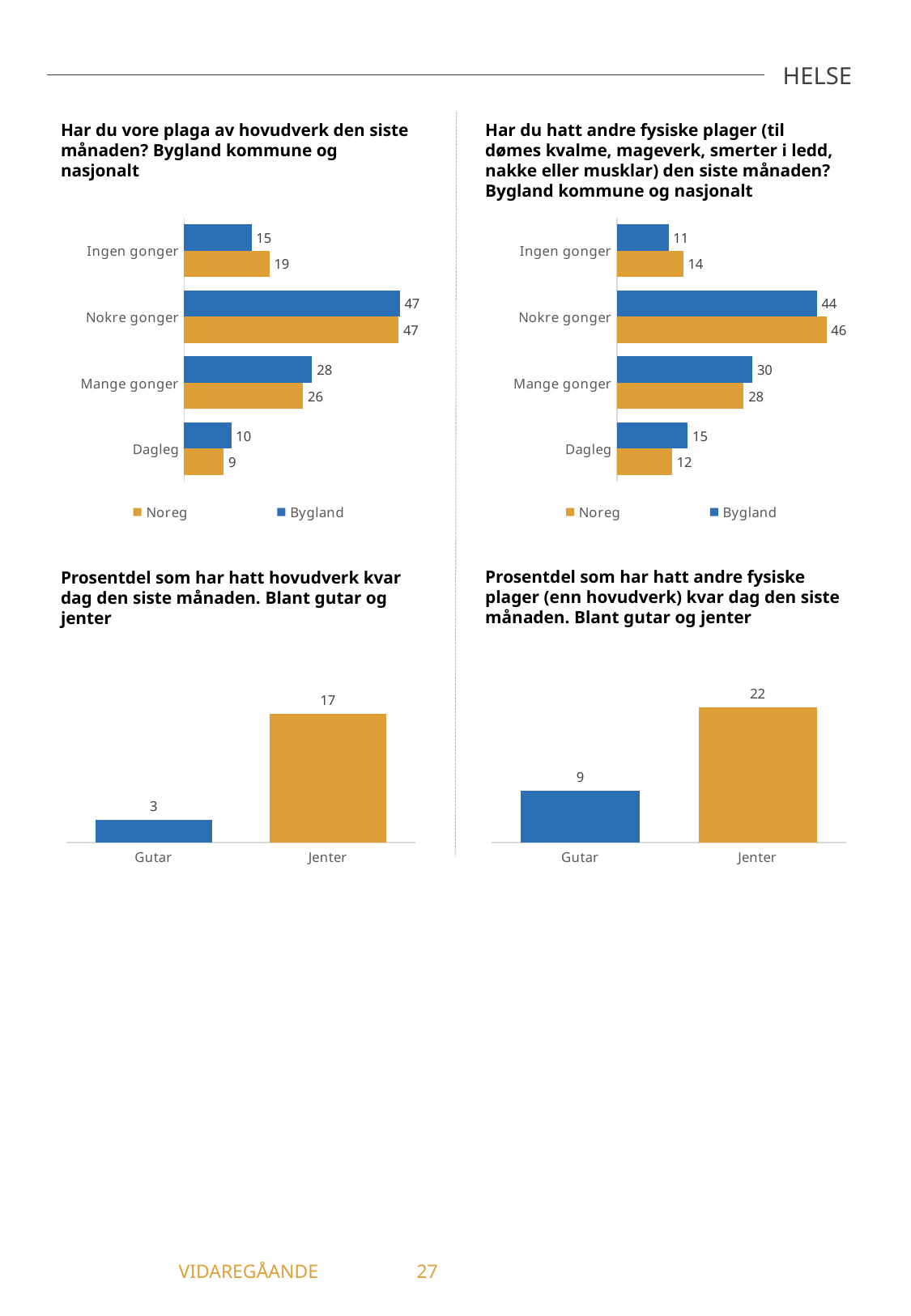
In the top-left chart (headache, Bygland kommune og nasjonalt), what is the value for Bygland in the 'Ingen gonger' category? 15 In the top-left chart (headache, Bygland kommune og nasjonalt), which category has the highest value for Bygland? Nokre gonger How many categories are shown in the top-left chart (headache, Bygland kommune og nasjonalt)? 4 In the top-right chart (other physical complaints, Bygland kommune og nasjonalt), which category has the lowest value for Bygland? Ingen gonger In the bottom-right chart (other physical complaints every day, gutar og jenter), what is the difference between Jenter and Gutar? 13 In the bottom-left chart (headache every day, gutar og jenter), what is the value for Jenter? 17 In the top-right chart (other physical complaints, Bygland kommune og nasjonalt), which is larger for 'Dagleg': Bygland or Noreg? Bygland What kind of chart is the bottom-right chart (other physical complaints every day, gutar og jenter)? Bar chart In the top-left chart (headache, Bygland kommune og nasjonalt), what is the difference between the Noreg and Bygland values for 'Ingen gonger'? 4 In the top-right chart (other physical complaints, Bygland kommune og nasjonalt), what is the value for Noreg in the 'Nokre gonger' category? 46 In the top-left chart (headache, Bygland kommune og nasjonalt), what is the value for Noreg in the 'Mange gonger' category? 26 How many series does the legend list in the top-right chart (other physical complaints, Bygland kommune og nasjonalt)? 2